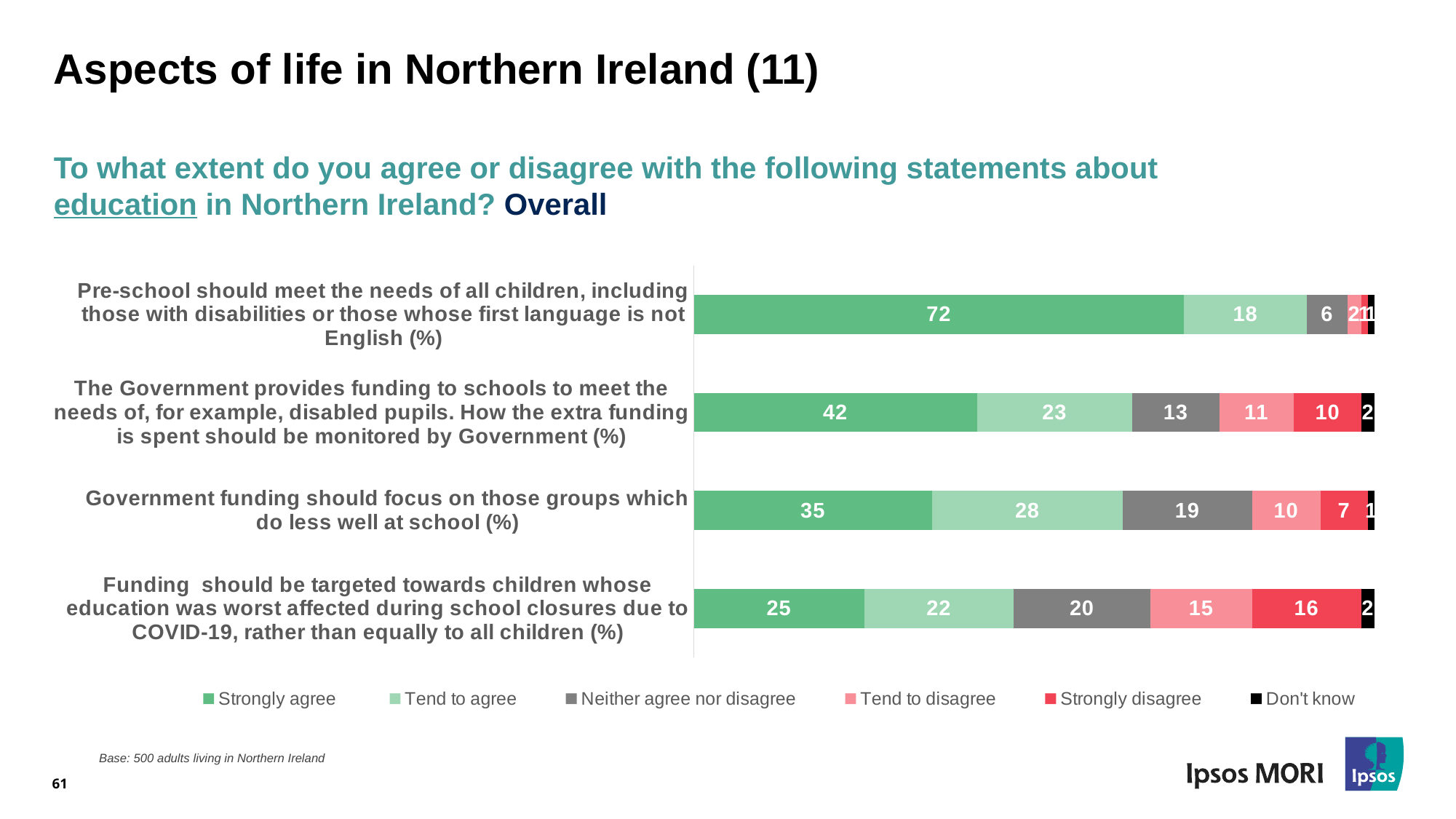
What is the total of the stacked bar for the statement that Government funding should focus on those groups which do less well at school? 100 Which statement has the highest 'Strongly agree' percentage? Pre-school should meet the needs of all children, including those with disabilities or those whose first language is not English What is the difference between the 'Strongly agree' percentages for the pre-school statement and the statement about Government monitoring extra funding? 30 How many statements are shown in the chart? 4 How many series does the legend list? 6 Which statement has the lowest 'Strongly agree' percentage? Funding should be targeted towards children whose education was worst affected during school closures due to COVID-19, rather than equally to all children What percentage neither agree nor disagree that Government funding should focus on those groups which do less well at school? 19 What percentage strongly agree that pre-school should meet the needs of all children, including those with disabilities or those whose first language is not English? 72 What percentage tend to agree that the Government should monitor how extra funding for, for example, disabled pupils is spent? 23 What percentage strongly disagree that funding should be targeted towards children whose education was worst affected during school closures due to COVID-19? 16 What kind of chart is shown on the slide? Stacked bar chart Which is larger: the 'Tend to disagree' percentage for the COVID-19 funding statement or for the statement about funding focusing on groups which do less well at school? The COVID-19 funding statement